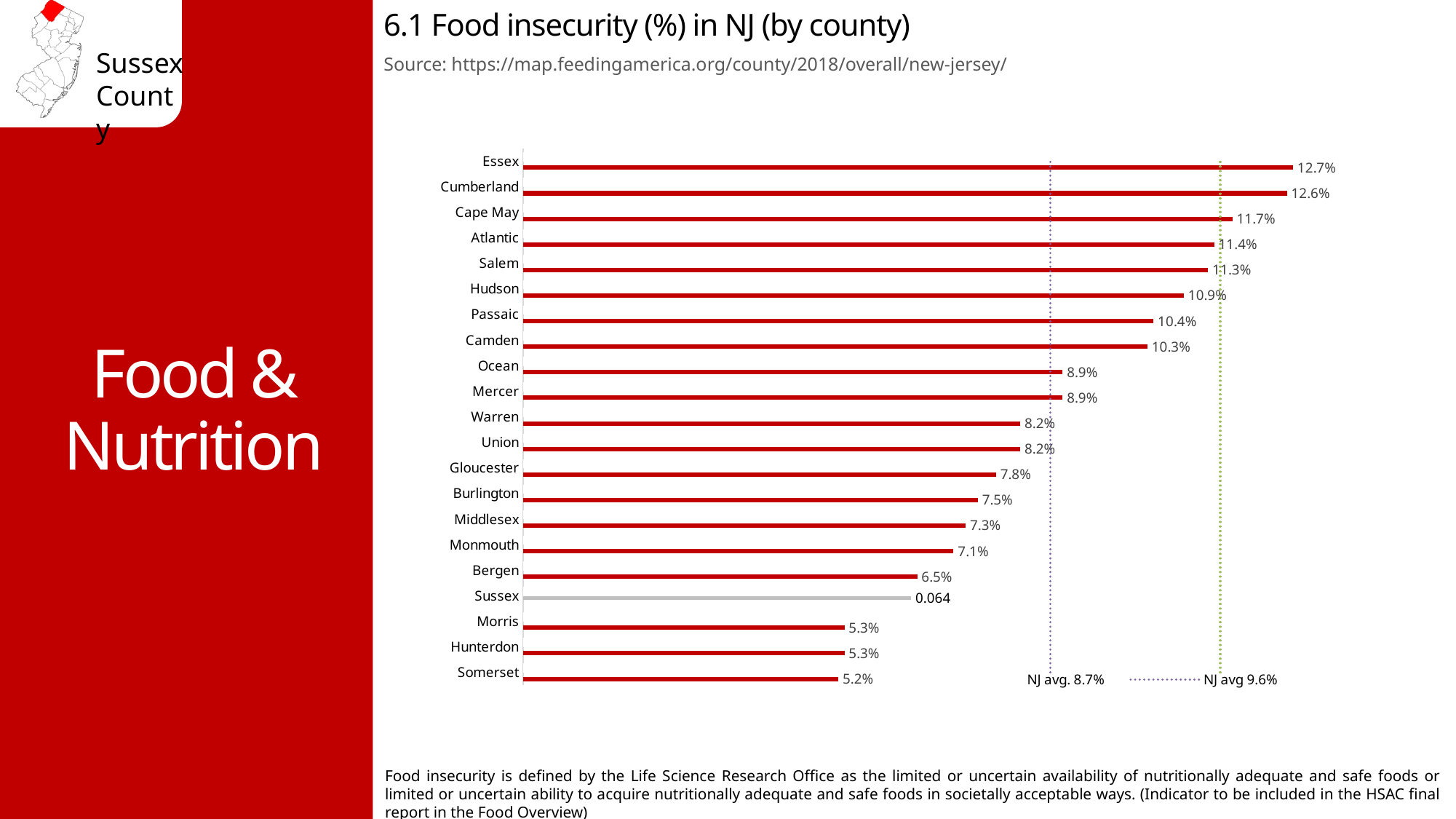
Which county has the lowest food insecurity percentage? Somerset Which county has a higher food insecurity value, Hudson or Passaic? Hudson What is the food insecurity value for Bergen? 6.5% Which county has the highest food insecurity percentage? Essex What is the difference between the food insecurity values for Cape May and Gloucester? 3.9 percentage points Do the bar values increase or decrease going from the top of the chart to the bottom? Decrease What two NJ average values are marked by the dotted vertical lines? 8.7% and 9.6% What is the food insecurity value for Camden? 10.3% What is the difference between the food insecurity values for Essex and Somerset? 7.5 percentage points What type of chart is shown on the slide? Bar chart What value is printed next to the Sussex bar? 0.064 How many counties are shown in the chart? 21